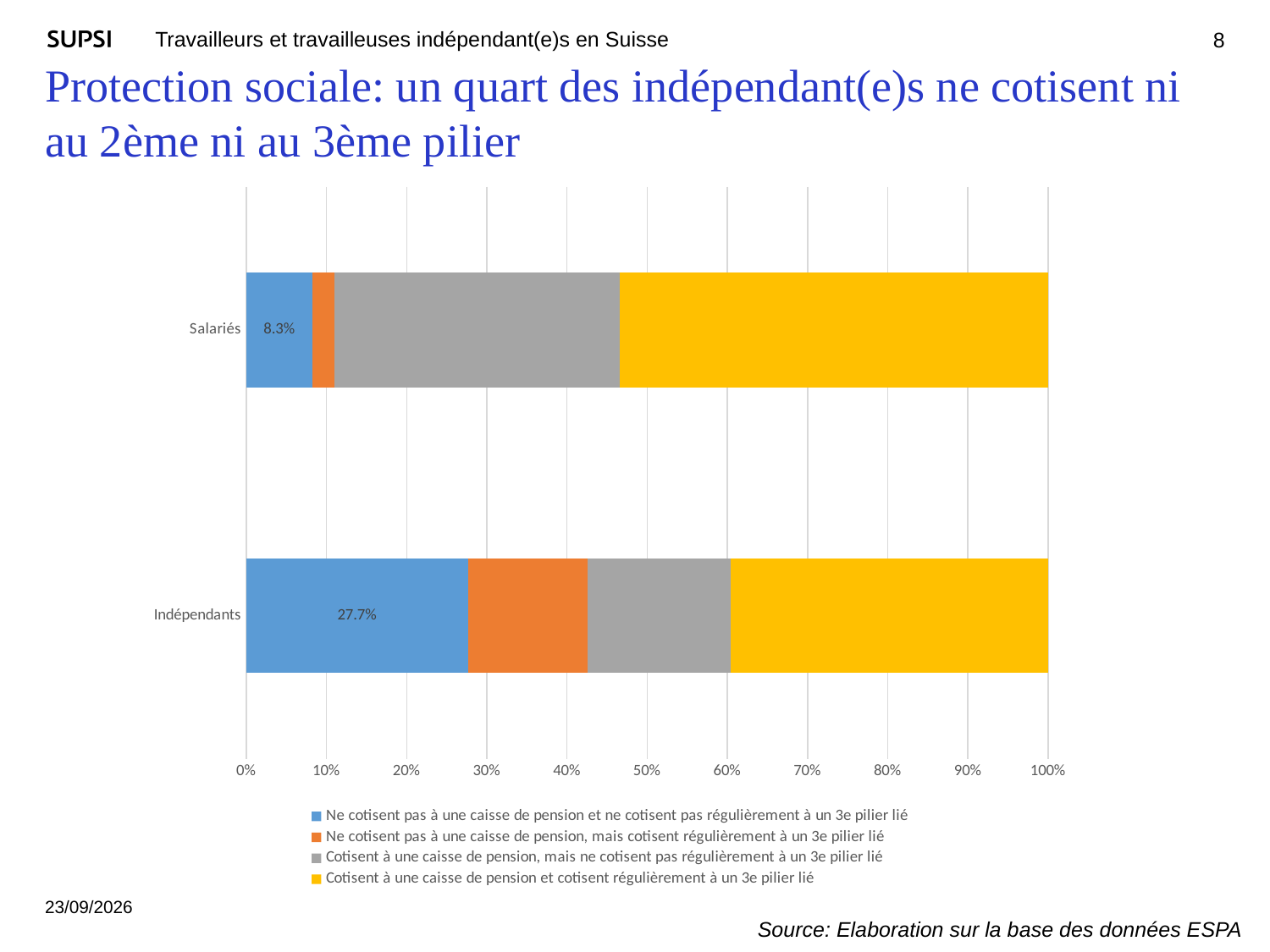
Is the orange segment (no pension fund but regular 3rd pillar) for Salariés greater or less than 10%? less What percentage of Salariés neither contribute to a pension fund nor regularly to a tied 3rd pillar (the blue segment)? 8.3% How many series does the chart legend list? 4 By how many percentage points does the blue segment for Indépendants exceed the blue segment for Salariés? 19.4 percentage points How many categories are shown on the vertical axis of the chart? 2 What kind of chart is shown on the slide? Stacked bar chart Is the yellow segment (contribute to both a pension fund and a 3rd pillar) for Salariés greater or less than 50%? greater What percentage of Indépendants neither contribute to a pension fund nor regularly to a tied 3rd pillar (the blue segment)? 27.7% Is the grey segment (pension fund but no regular 3rd pillar) for Salariés greater or less than 30%? greater Which category has the larger share of people who contribute neither to a pension fund nor to a 3rd pillar: Salariés or Indépendants? Indépendants Which colour represents the series 'Cotisent à une caisse de pension et cotisent régulièrement à un 3e pilier lié'? Yellow